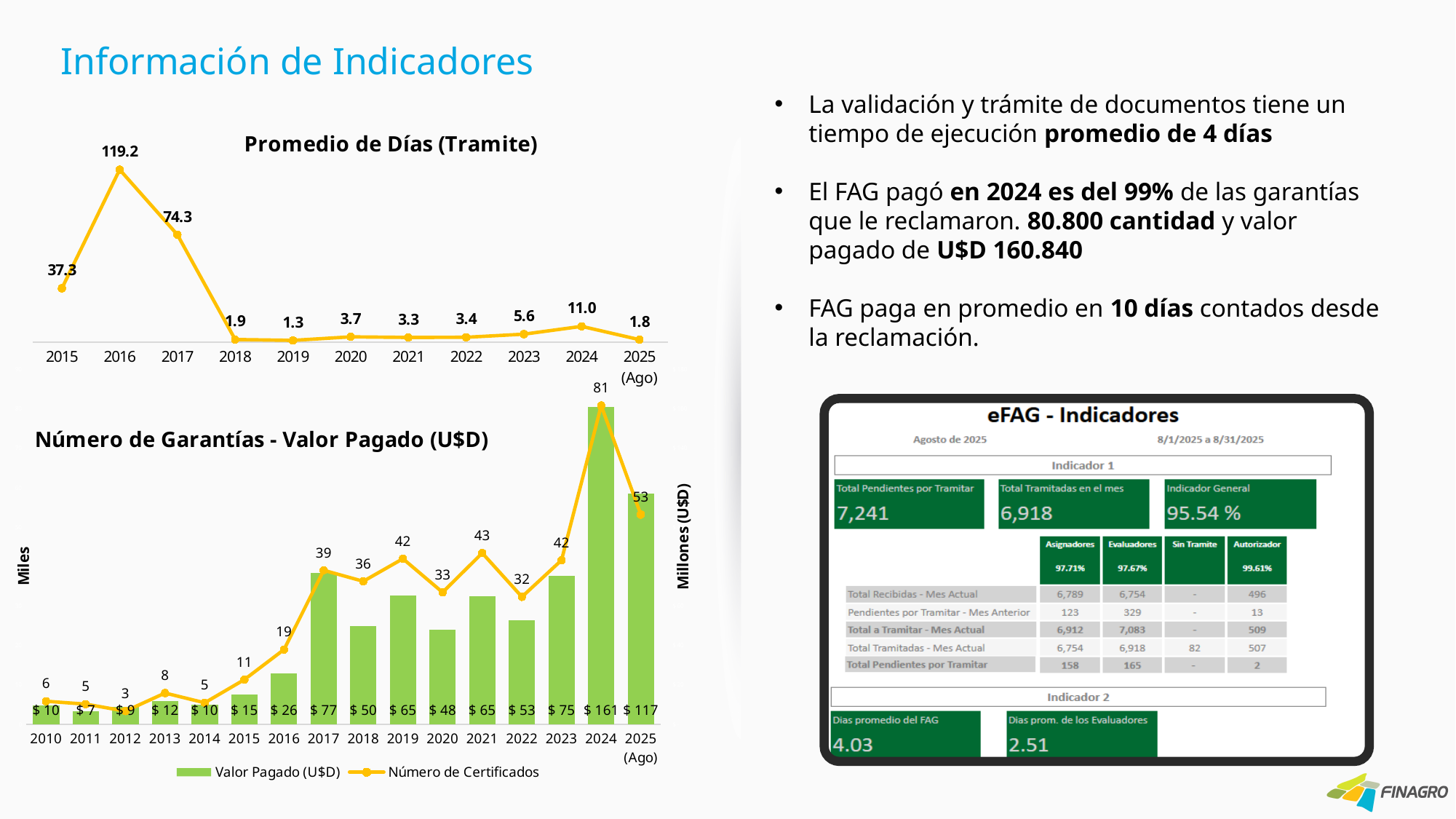
In the 'Número de Garantías - Valor Pagado (U$D)' chart, what is the Número de Certificados for 2021? 43 In the 'Número de Garantías - Valor Pagado (U$D)' chart, which year has the highest Número de Certificados? 2024 In the 'Promedio de Días (Tramite)' chart, do the values rise or fall from 2016 to 2019? fall In the 'Número de Garantías - Valor Pagado (U$D)' chart, how many series does the legend list? 2 In the 'Número de Garantías - Valor Pagado (U$D)' chart, which year has the lowest Número de Certificados? 2012 In the 'Número de Garantías - Valor Pagado (U$D)' chart, what is the Valor Pagado (U$D) for 2024? $ 161 In the 'Número de Garantías - Valor Pagado (U$D)' chart, what is the difference in Valor Pagado (U$D) between 2024 and 2025 (Ago)? $ 44 In the 'Promedio de Días (Tramite)' chart, what is the difference between the 2016 and 2017 values? 44.9 In the 'Número de Garantías - Valor Pagado (U$D)' chart, is the Valor Pagado (U$D) larger in 2017 or in 2023? 2017 In the 'Promedio de Días (Tramite)' chart, which year has the lowest value? 2019 In the 'Promedio de Días (Tramite)' chart, how many data points are plotted? 11 In the 'Promedio de Días (Tramite)' chart, what is the value for 2016? 119.2